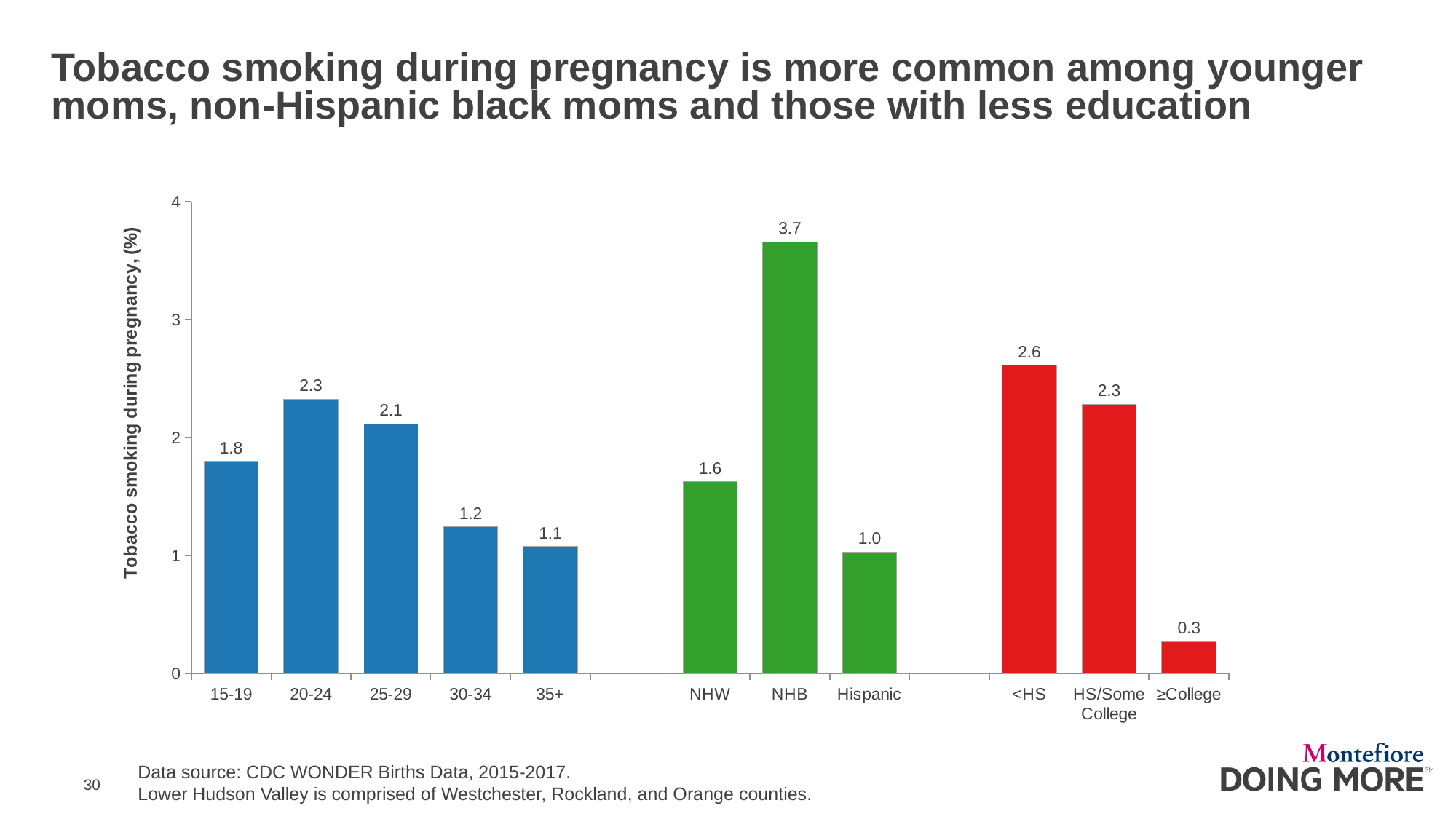
Do the values rise or fall across the age groups from 20-24 to 35+? fall Which category has the lowest value on the chart? ≥College What kind of chart is shown on the slide? bar chart Which category has the highest value on the chart? NHB How many categories are shown on the x axis? 11 What is the difference between the values for <HS and ≥College? 2.3 What is the difference between the values for NHB and NHW? 2.1 Which is larger, the value for 15-19 or the value for 35+? 15-19 What is the value for ≥College? 0.3 What is the value for NHB? 3.7 Is the value for Hispanic greater or less than 2? less What is the value for the 20-24 age group? 2.3